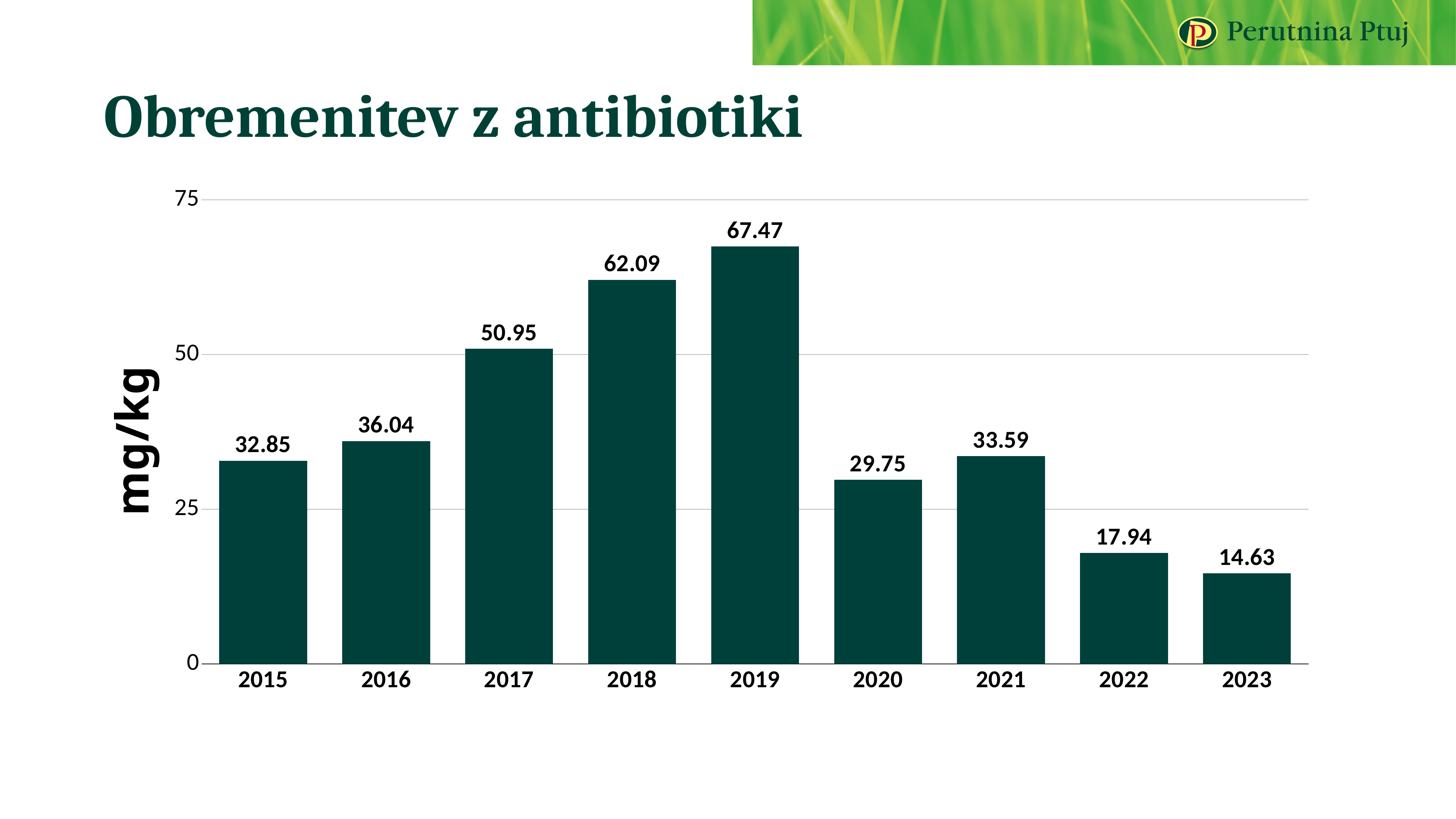
Which year has the highest value? 2019 What kind of chart is shown on the slide? bar chart Is the value for 2017 greater or less than 50? greater What is the value for 2016? 36.04 How many years are shown on the x axis? 9 Which year has the lowest value? 2023 What is the value for 2019? 67.47 What is the value for 2023? 14.63 Which is larger, the value for 2021 or the value for 2020? 2021 What is the difference between the values for 2018 and 2017? 11.14 What is the difference between the values for 2019 and 2023? 52.84 What is the label on the y axis? mg/kg